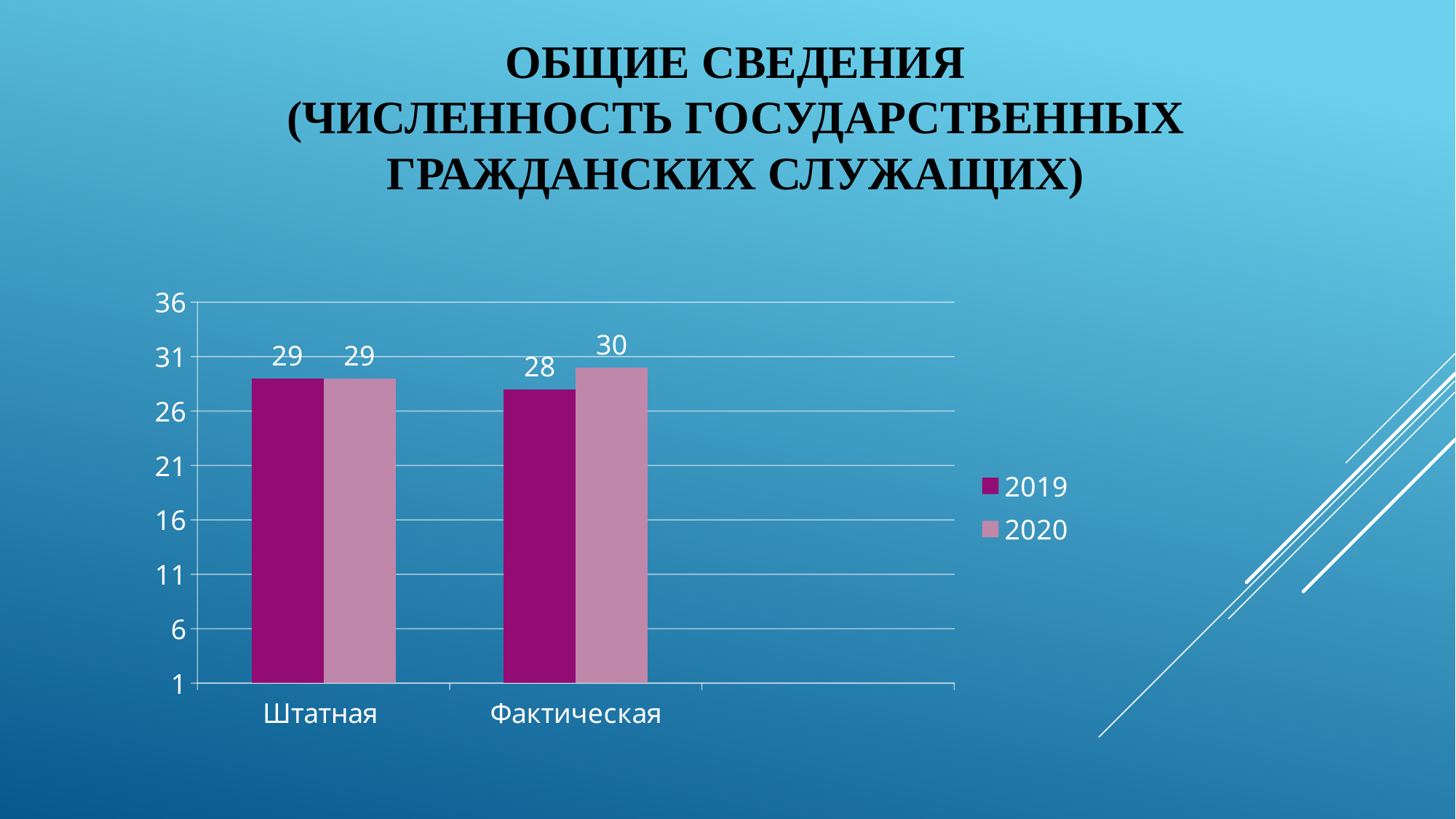
Which category has the highest value in the 2020 series? Фактическая How many categories are shown on the x axis? 2 What is the value for Фактическая in 2020? 30 Which category has the lowest value in the 2019 series? Фактическая How many series does the legend list? 2 What is the value for Штатная in 2020? 29 What kind of chart is shown on the slide? Bar chart What is the value for Штатная in 2019? 29 What is the value for Фактическая in 2019? 28 Which series is shown in the lighter pink colour? 2020 What is the difference between the 2020 and 2019 values for Фактическая? 2 Which is larger for Фактическая: the 2019 value or the 2020 value? 2020